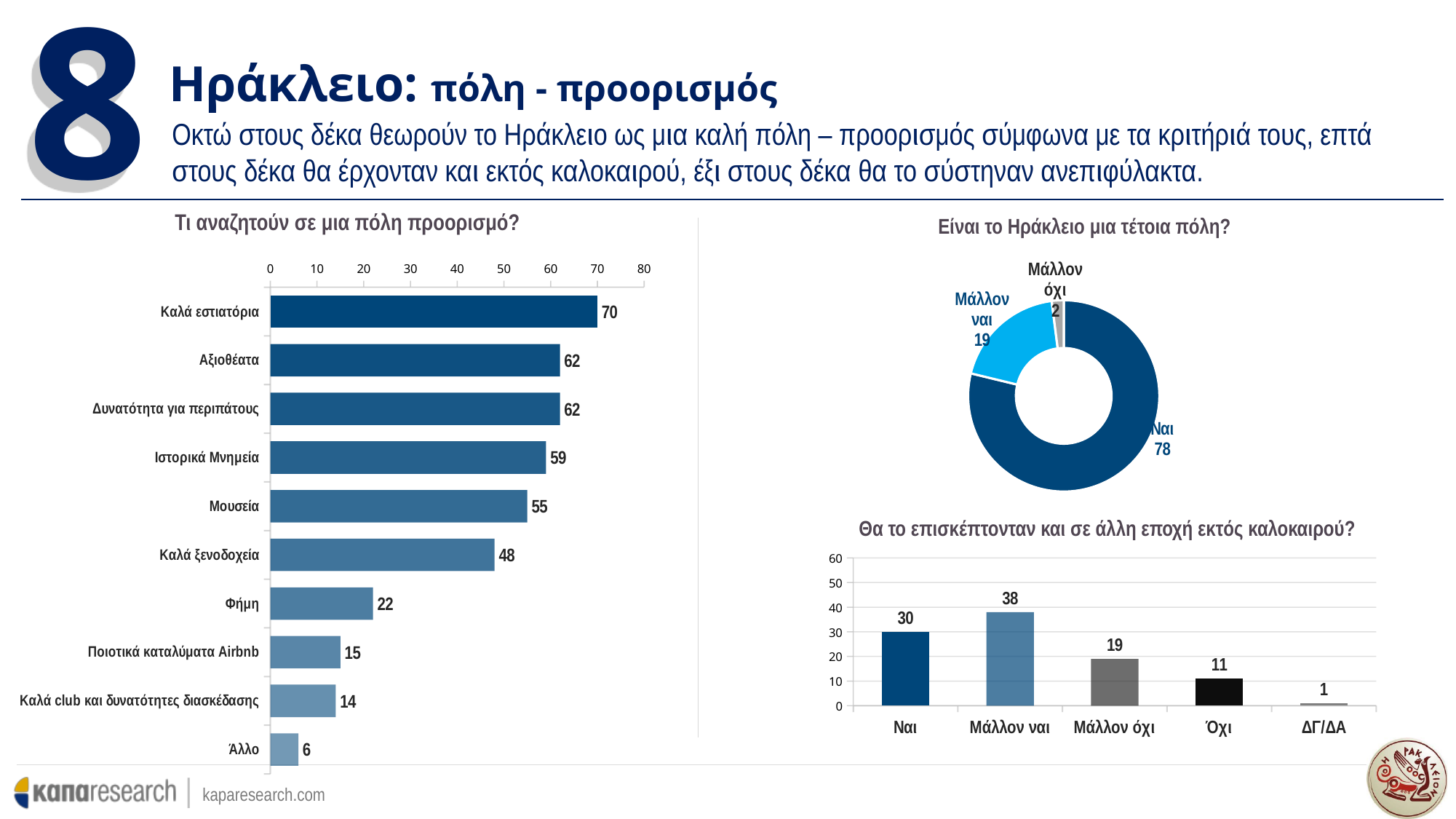
In the chart 'Είναι το Ηράκλειο μια τέτοια πόλη?', what is the value for 'Μάλλον όχι'? 2 In the chart 'Είναι το Ηράκλειο μια τέτοια πόλη?', what is the value for 'Ναι'? 78 In the chart 'Θα το επισκέπτονταν και σε άλλη εποχή εκτός καλοκαιρού?', which category has the highest value? Μάλλον ναι In the chart 'Τι αναζητούν σε μια πόλη προορισμό?', what is the difference between 'Μουσεία' and 'Καλά ξενοδοχεία'? 7 In the chart 'Τι αναζητούν σε μια πόλη προορισμό?', how many categories are shown? 10 In the chart 'Τι αναζητούν σε μια πόλη προορισμό?', what is the value for 'Καλά εστιατόρια'? 70 In the chart 'Θα το επισκέπτονταν και σε άλλη εποχή εκτός καλοκαιρού?', what is the value for 'ΔΓ/ΔΑ'? 1 In the chart 'Τι αναζητούν σε μια πόλη προορισμό?', which is larger: 'Φήμη' or 'Ποιοτικά καταλύματα Airbnb'? Φήμη In the chart 'Τι αναζητούν σε μια πόλη προορισμό?', which category has the lowest value? Άλλο In the chart 'Θα το επισκέπτονταν και σε άλλη εποχή εκτός καλοκαιρού?', what is the difference between 'Μάλλον ναι' and 'Ναι'? 8 What kind of chart is 'Είναι το Ηράκλειο μια τέτοια πόλη?'? Donut chart What kind of chart is 'Τι αναζητούν σε μια πόλη προορισμό?'? Bar chart